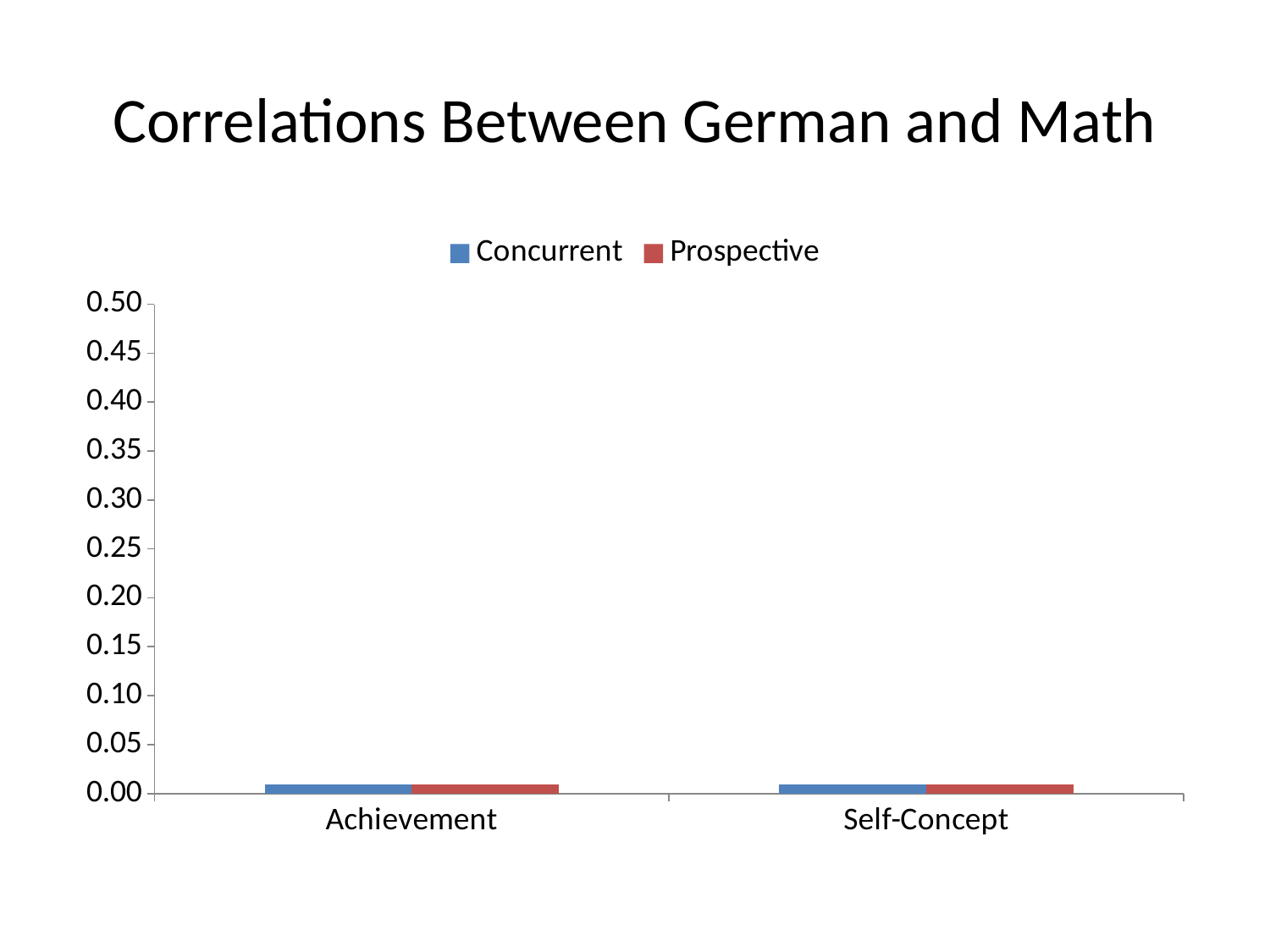
How many categories are shown on the x axis? 2 What is the highest value shown on the y axis? 0.50 Is the Concurrent value for Achievement greater or less than 0.05? less Is the Prospective value for Achievement greater or less than 0.05? less How many series does the legend list? 2 What is the title of the chart? Correlations Between German and Math Is the Prospective value for Self-Concept greater or less than 0.10? less Which series is shown in red? Prospective What kind of chart is shown on the slide? bar chart